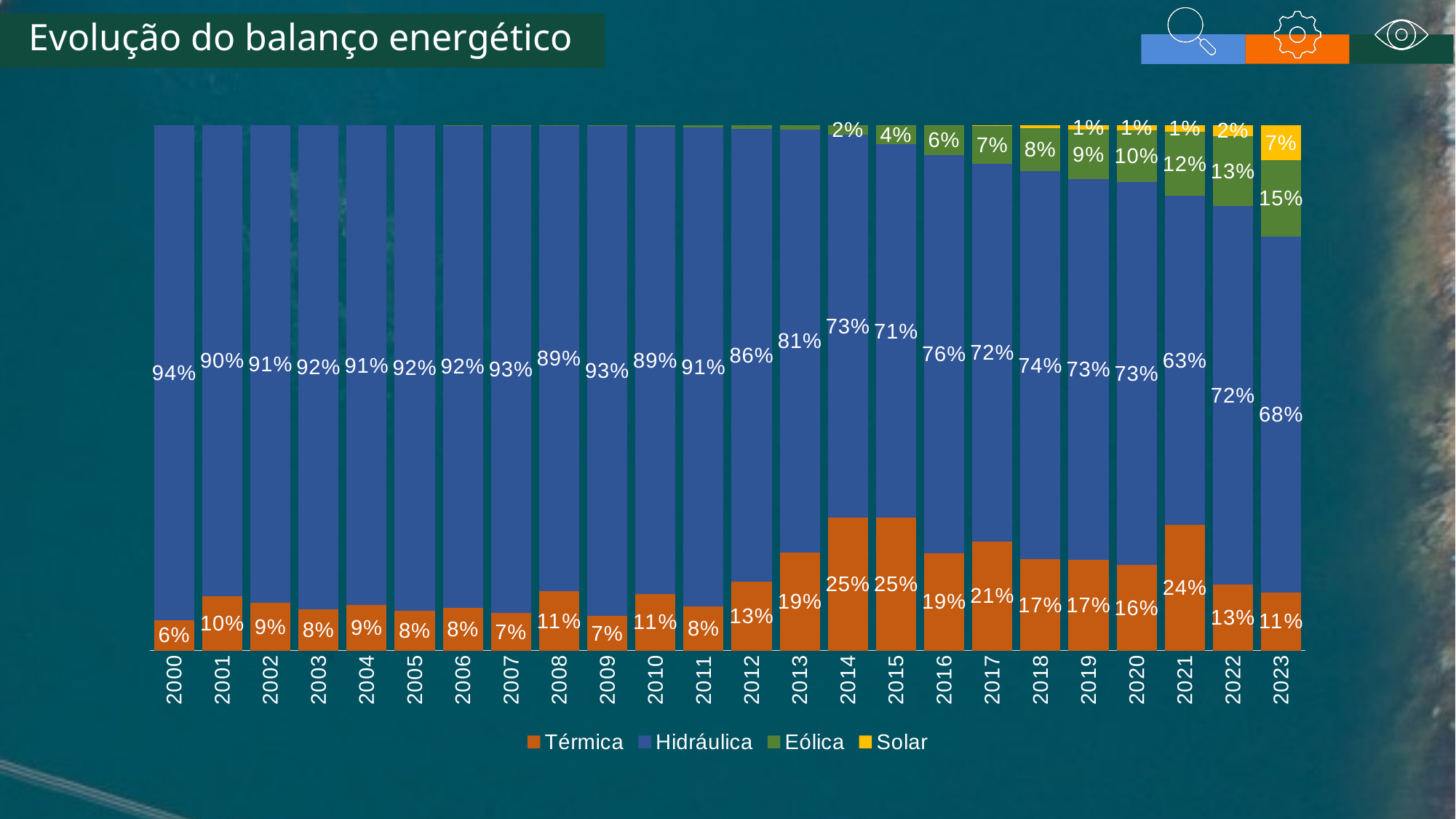
What is the Térmica value for 2021? 24% How many years are shown on the x axis? 24 What kind of chart is shown on the slide? Stacked bar chart Does the Eólica share rise or fall from 2014 to 2023? Rise What is the difference between the Eólica value in 2023 and in 2014? 13 percentage points What is the Solar value for 2023? 7% What is the Hidráulica value for 2000? 94% Which is larger, the Térmica value for 2021 or for 2022? 2021 In which year is the Hidráulica share highest? 2000 In which year is the Hidráulica share lowest? 2021 How many series does the legend list? 4 What is the Eólica value for 2023? 15%